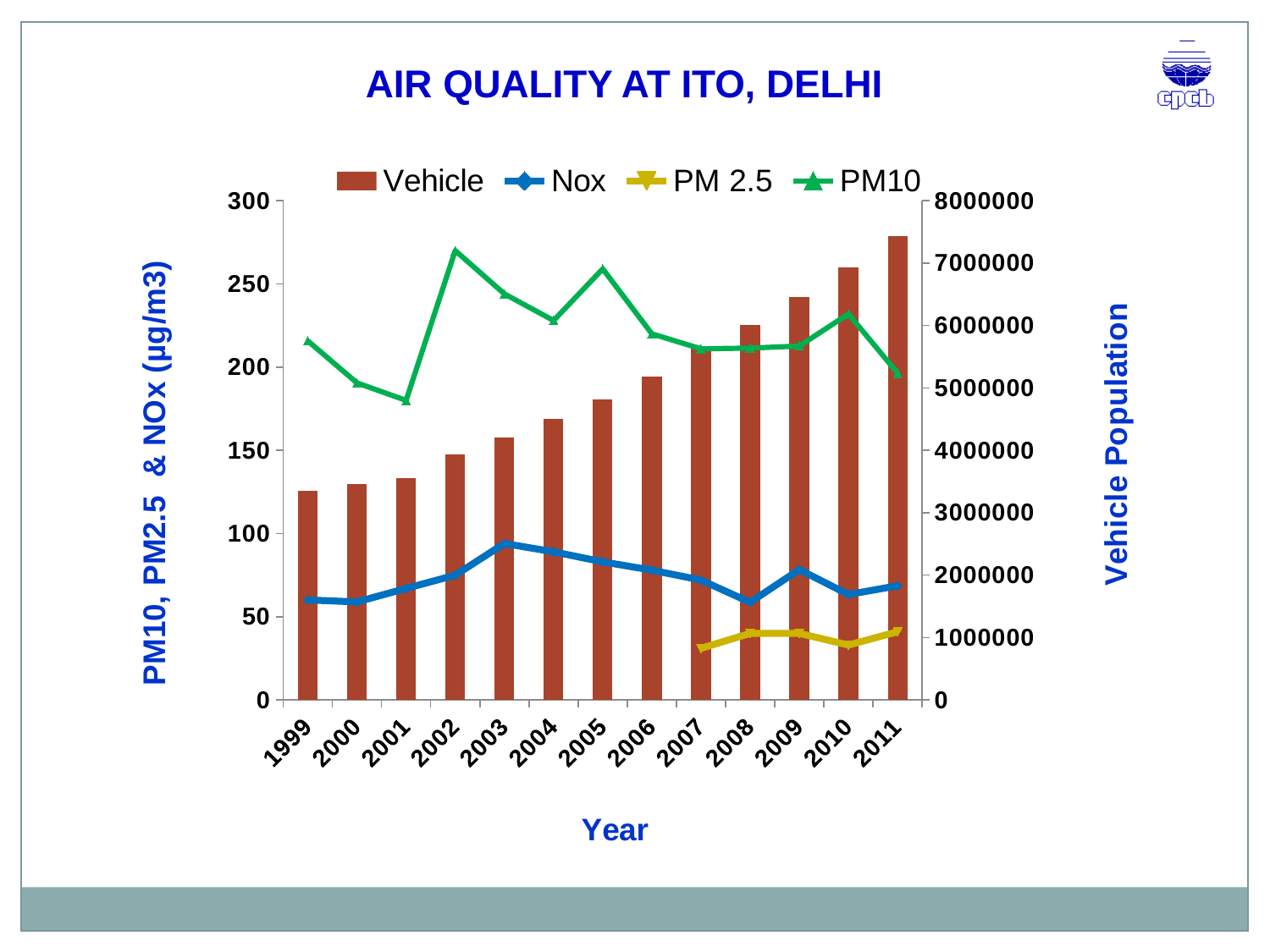
How many years are shown on the x axis? 13 What is the title of the right-hand vertical axis? Vehicle Population How many series does the legend list? 4 Is the Vehicle population in 2011 greater or less than 7000000? greater Does the Vehicle population rise or fall from 1999 to 2011? rise In which year does the Nox line reach its highest value? 2003 In which year does the PM10 line reach its highest value? 2002 In which year is the Vehicle population highest? 2011 Is the Nox value in 2003 greater or less than 100? less In which year is the Vehicle population lowest? 1999 What kind of chart is shown on the slide? A combined bar and line chart Is the PM10 value in 2002 greater or less than 250? greater